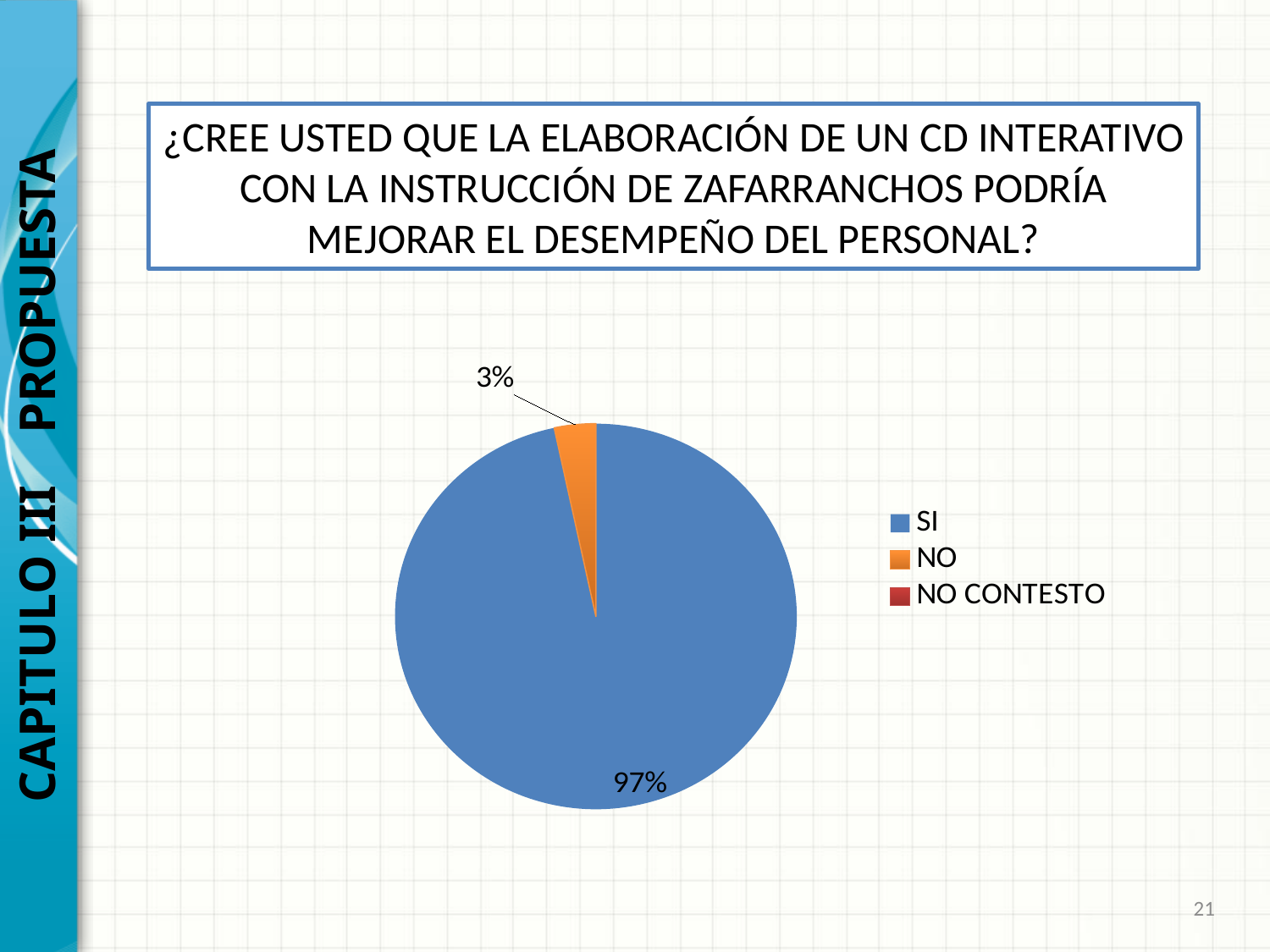
What kind of chart is shown on the slide? pie chart Which of the two labelled slices is larger, SI or NO? SI What percentage of the pie is labelled for NO? 3% What percentage of the pie is labelled for SI? 97% Is the share for SI greater or less than 50%? greater What is the difference in percentage points between the SI slice and the NO slice? 94 Which colour represents SI in the pie chart? blue Which category has the largest slice of the pie? SI Which colour represents NO in the pie chart? orange How many entries does the legend list? 3 Is the share for NO greater or less than 10%? less